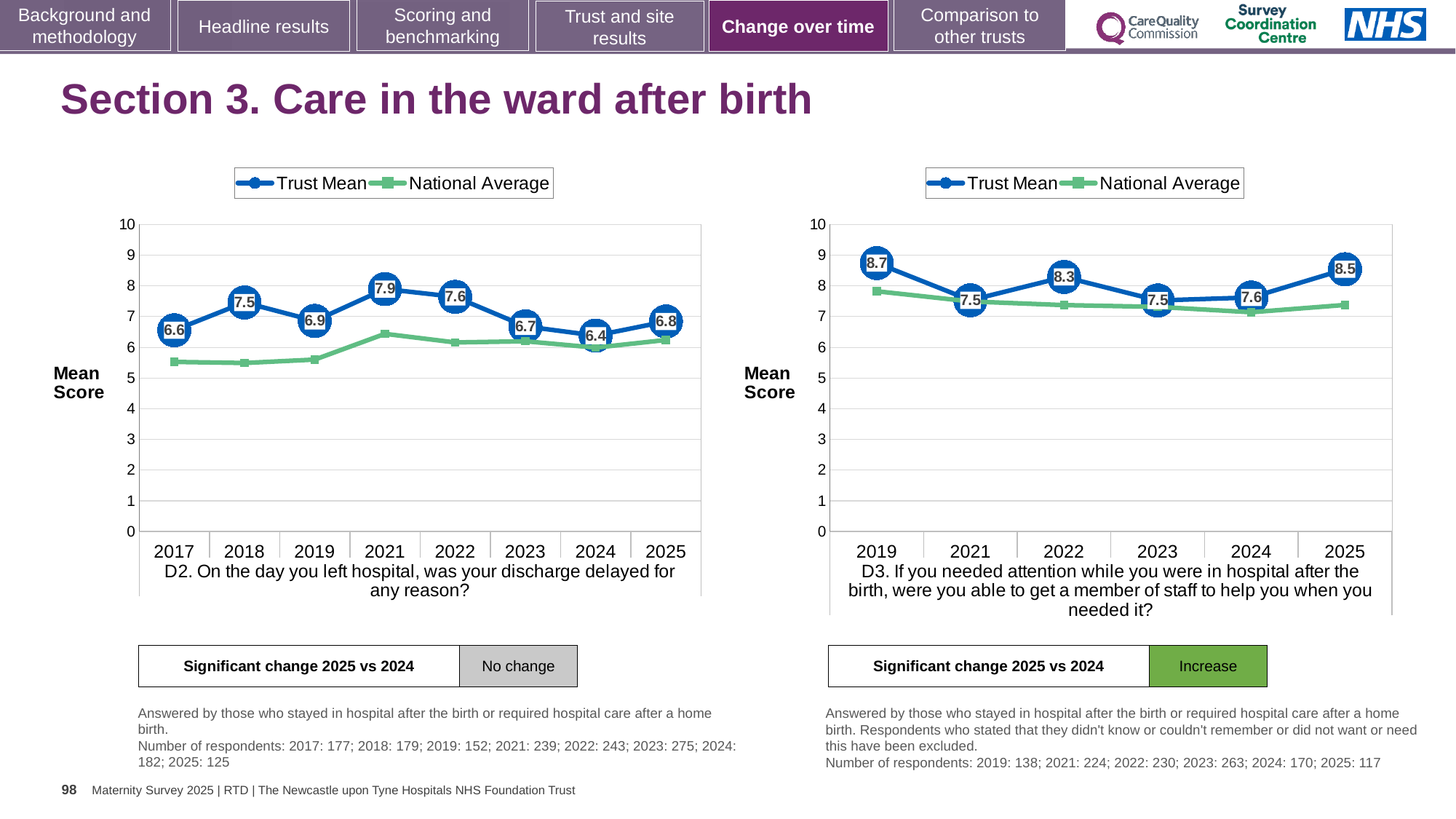
In the right chart (D3), how many series does the legend list? 2 What type of chart is the right chart (D3)? Line chart In the left chart (D2), what is the Trust Mean for 2021? 7.9 In the left chart (D2), how many years are shown on the x axis? 8 In the right chart (D3), what is the Trust Mean for 2019? 8.7 In the left chart (D2), which year has the highest Trust Mean? 2021 In the left chart (D2), what is the Trust Mean for 2025? 6.8 In the left chart (D2), what is the difference between the Trust Mean for 2021 and 2024? 1.5 In the right chart (D3), is the Trust Mean for 2022 larger than the Trust Mean for 2023? Yes In the left chart (D2), which year has the lowest Trust Mean? 2024 In the right chart (D3), which year has the highest Trust Mean? 2019 In the left chart (D2), is the National Average for 2017 greater or less than 6? less